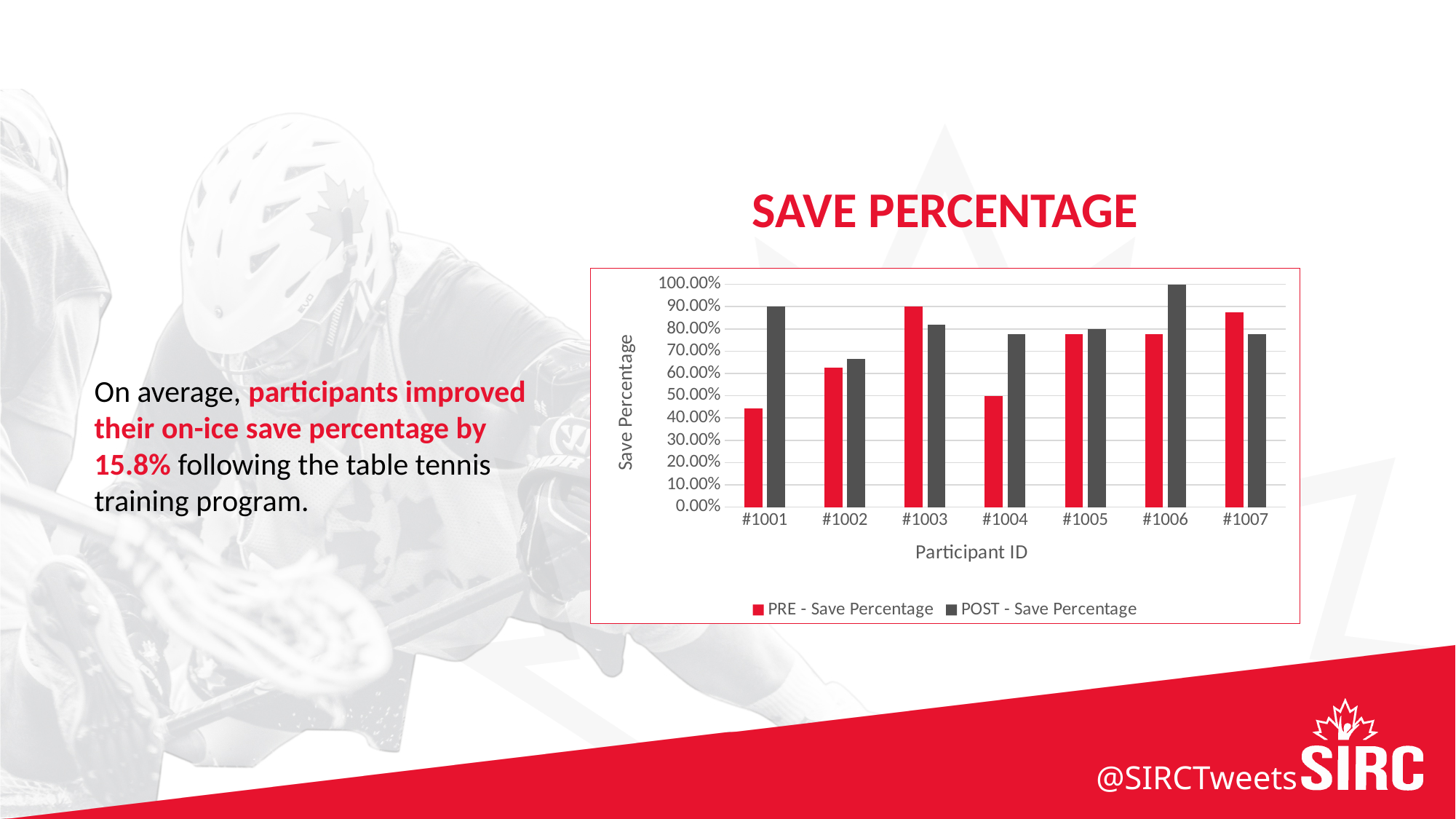
What is the PRE - Save Percentage for participant #1004? 50.00% Is the PRE - Save Percentage for participant #1001 greater or less than 50.00%? less What is the POST - Save Percentage for participant #1006? 100.00% How many participant IDs are shown on the x axis? 7 For participant #1004, which is larger: the PRE - Save Percentage or the POST - Save Percentage? POST - Save Percentage What kind of chart is shown on the slide? bar chart For participant #1003, which is larger: the PRE - Save Percentage or the POST - Save Percentage? PRE - Save Percentage What is the title of the chart? SAVE PERCENTAGE How many series does the legend list? 2 Which participant has the highest POST - Save Percentage? #1006 Which participant has the lowest PRE - Save Percentage? #1001 Is the POST - Save Percentage for participant #1002 greater or less than 60.00%? greater